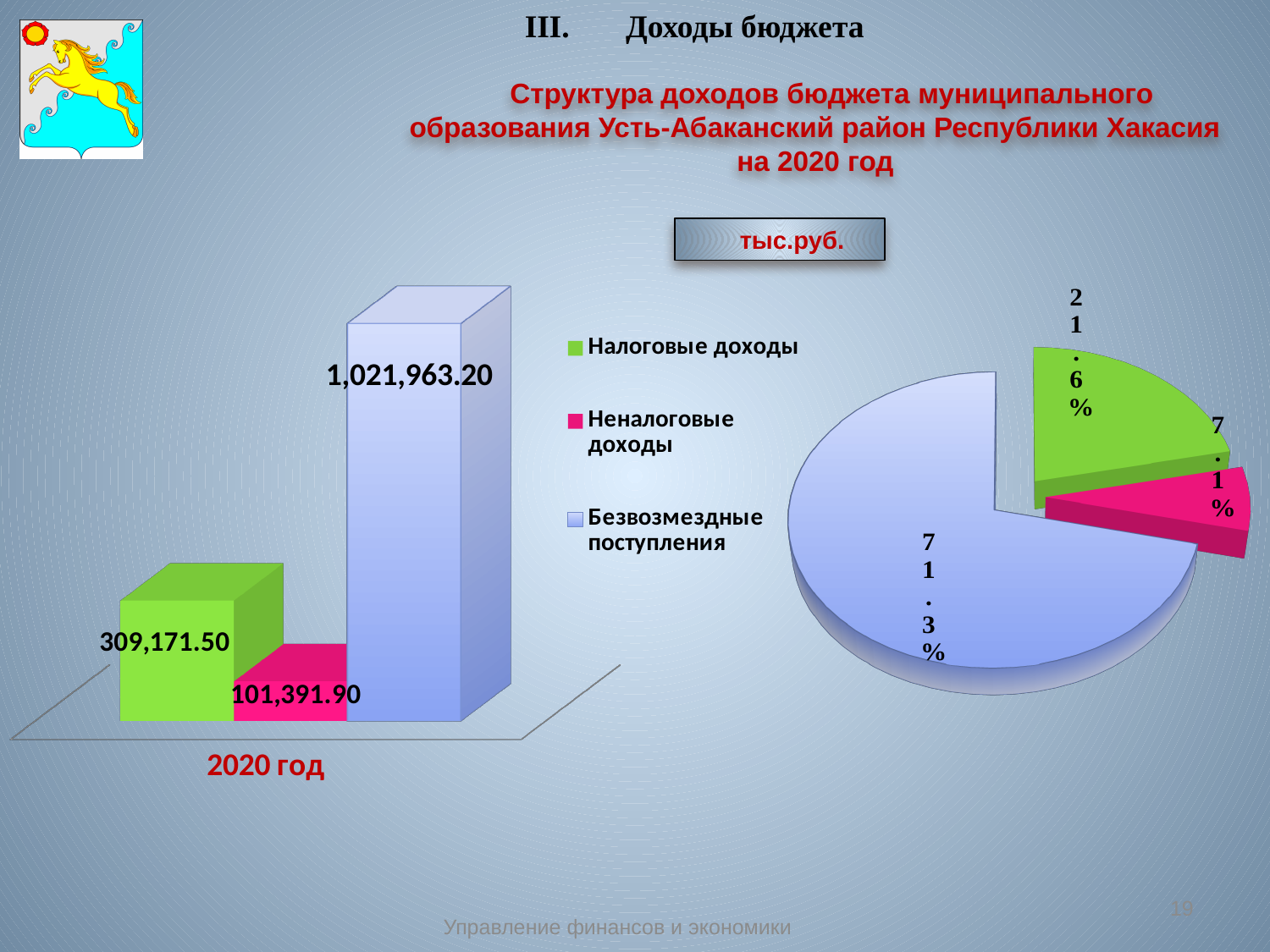
On the bar chart on the left, which is larger: Налоговые доходы or Неналоговые доходы? Налоговые доходы On the bar chart on the left, what is the value for Неналоговые доходы in 2020 год? 101,391.90 On the bar chart on the left, what is the difference between Налоговые доходы and Неналоговые доходы? 207,779.60 On the bar chart on the left, what is the value for Безвозмездные поступления in 2020 год? 1,021,963.20 How many series does the legend list? 3 On the bar chart on the left, which series has the highest value? Безвозмездные поступления On the bar chart on the left, what is the value for Налоговые доходы in 2020 год? 309,171.50 What kind of chart is shown on the right side of the slide? Pie chart On the pie chart on the right, what share does Безвозмездные поступления have? 71.3% What kind of chart is shown on the left side of the slide? Bar chart On the pie chart on the right, what share does Налоговые доходы have? 21.6% On the bar chart on the left, which series has the lowest value? Неналоговые доходы